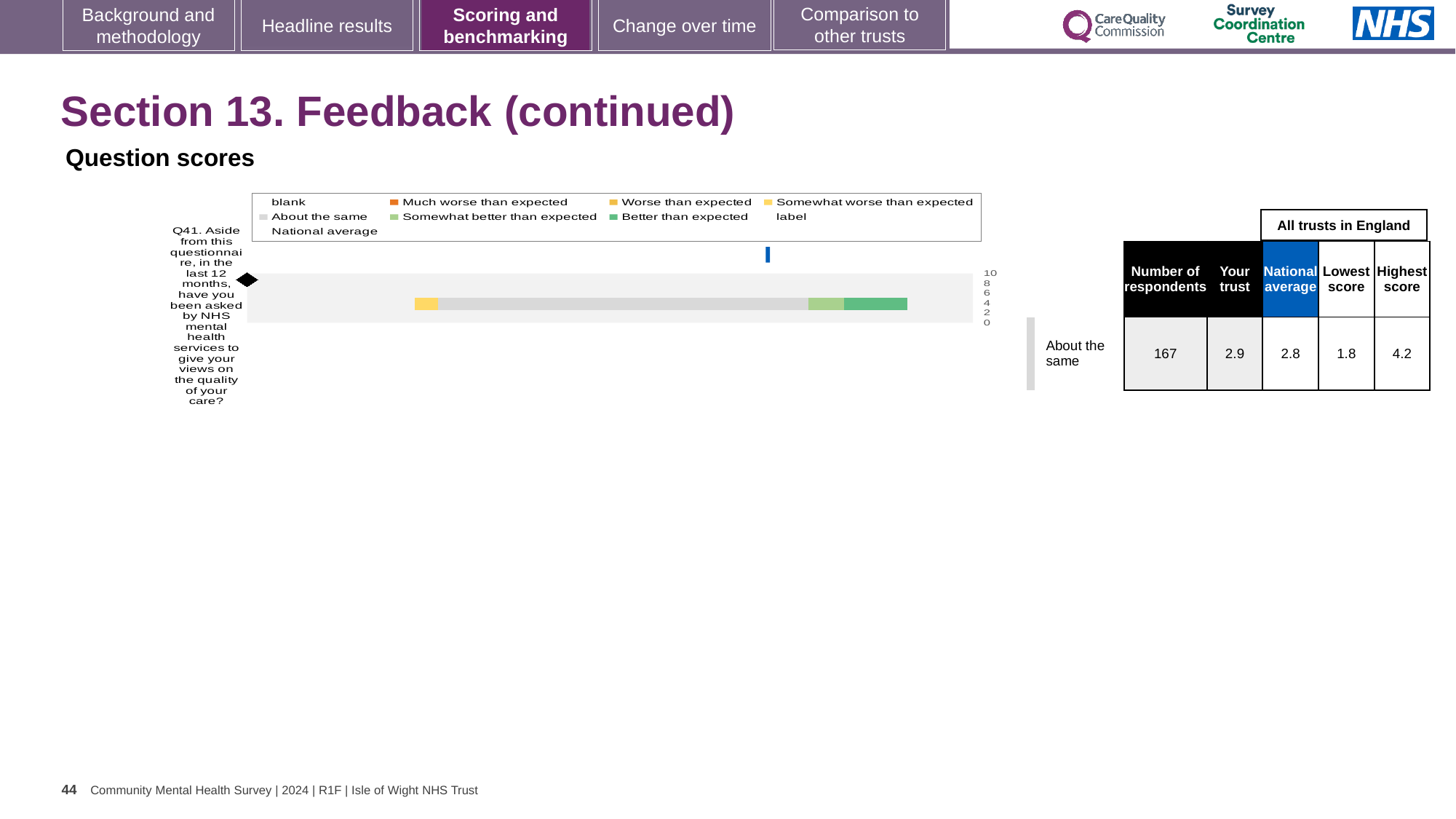
What is the national average score for Q41 shown in the table? 2.8 What is the highest score among all trusts in England for Q41? 4.2 How many respondents answered Q41? 167 What is the difference between the 'Your trust' score and the national average for Q41? 0.1 What is the lowest score among all trusts in England for Q41? 1.8 Which is larger for Q41, the 'Your trust' score or the national average? Your trust What is the 'Your trust' score for Q41 shown in the table next to the chart? 2.9 What kind of chart is shown on the slide for Q41? bar chart Which benchmark category is the trust's result for Q41 placed in? About the same How many questions are plotted in the chart on the slide? 1 Which legend entry is shown in dark green in the chart's legend? Better than expected What is the difference between the highest and lowest scores for Q41 across all trusts in England? 2.4